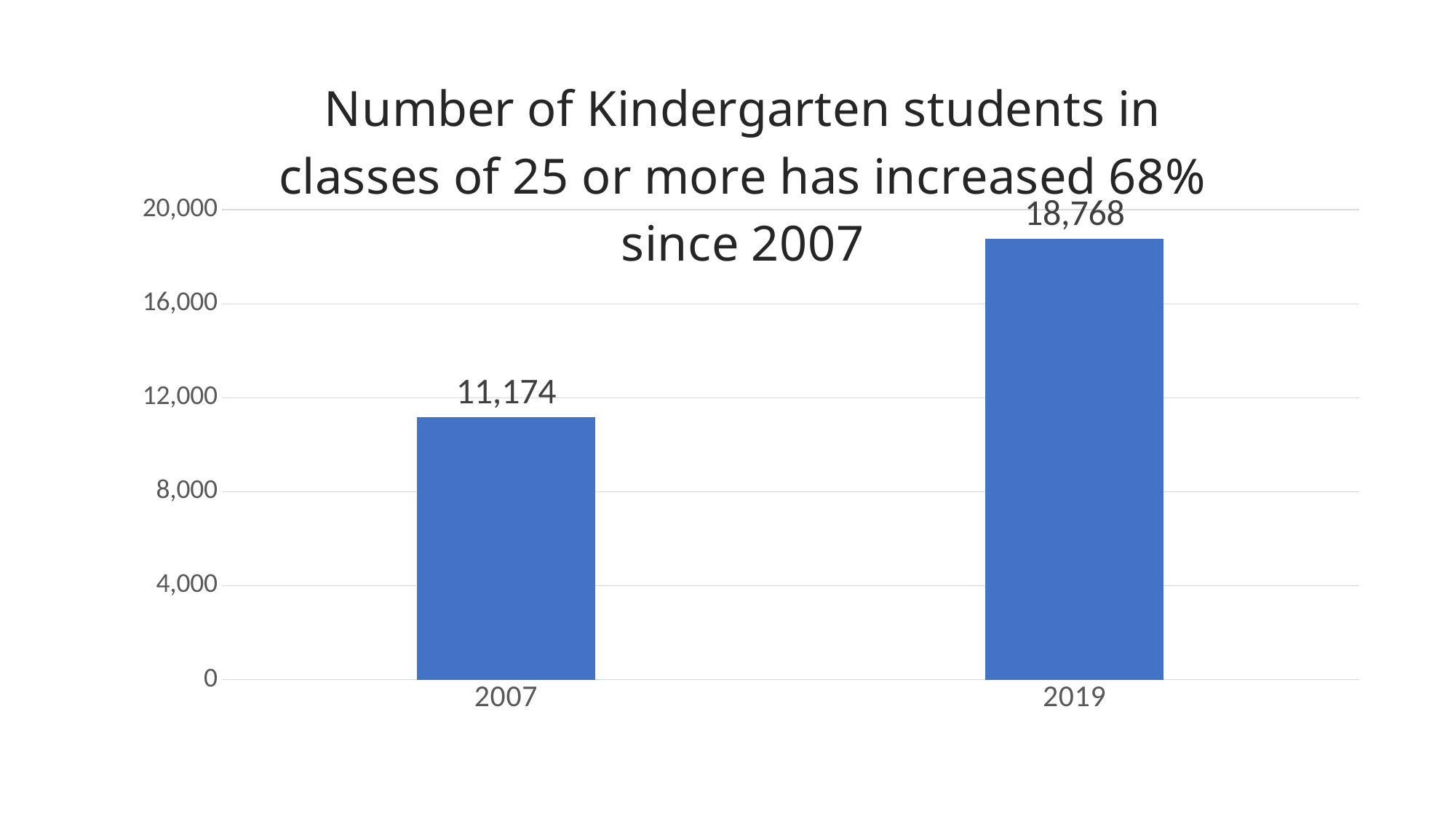
What is the title of the chart? Number of Kindergarten students in classes of 25 or more has increased 68% since 2007 Which year has the lowest value? 2007 Is the value for 2007 greater or less than 12,000? less What is the value for 2007? 11,174 Do the values rise or fall from 2007 to 2019? rise How many bars are shown in the chart? 2 What is the value for 2019? 18,768 Is the value for 2019 greater or less than 16,000? greater What kind of chart is shown on the slide? bar chart Which is larger, the value for 2007 or the value for 2019? 2019 Which year has the highest value? 2019 What is the difference between the values for 2019 and 2007? 7,594